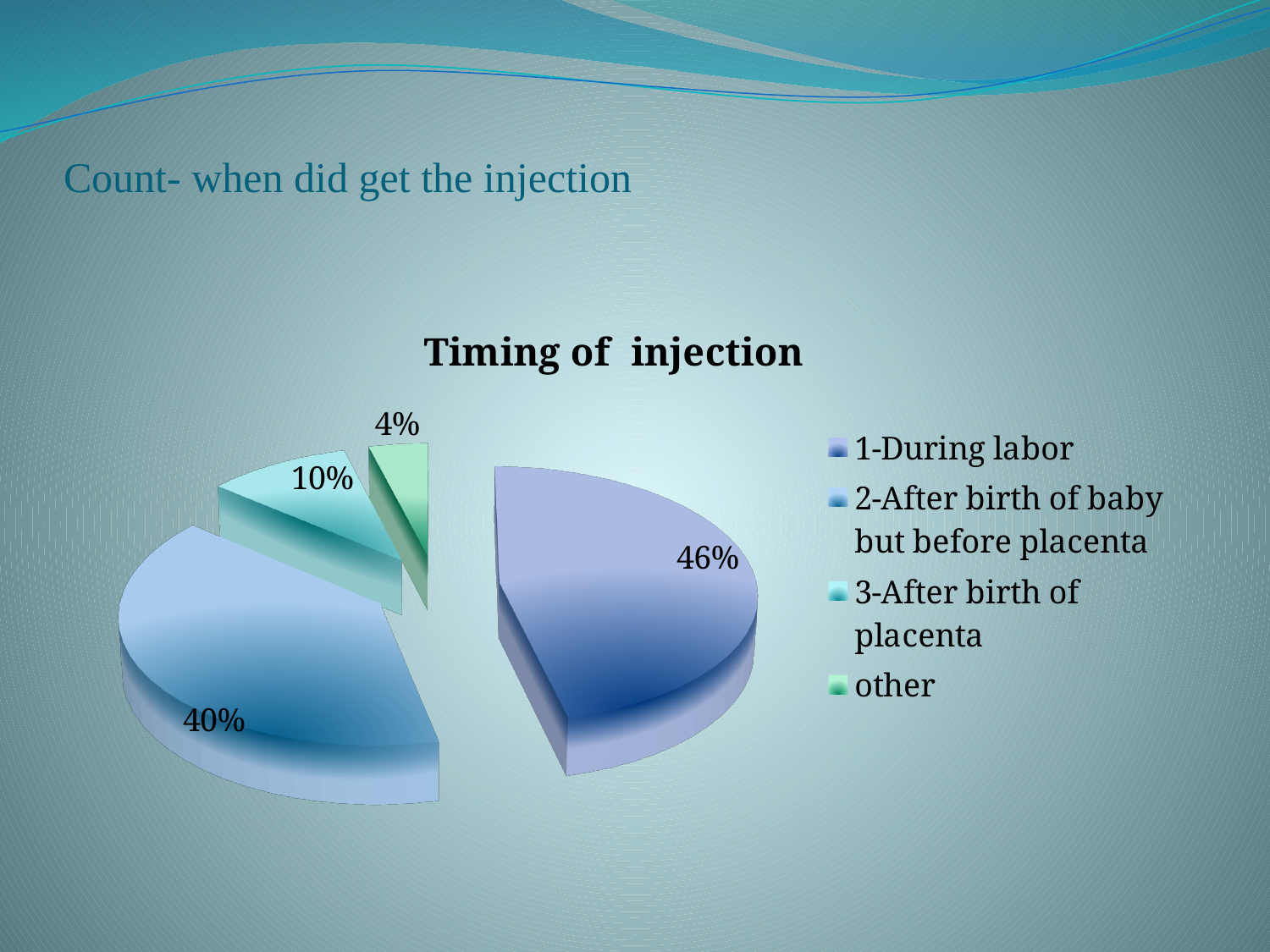
What share of the pie is labelled for '3-After birth of placenta'? 10% Which is larger: the slice for '3-After birth of placenta' or the slice for 'other'? 3-After birth of placenta What is the title of the chart? Timing of injection What share of the pie is labelled for 'other'? 4% Which category has the smallest slice of the pie? other What share of the pie is labelled for '2-After birth of baby but before placenta'? 40% What kind of chart is shown on the slide? pie chart What is the difference in percentage points between '3-After birth of placenta' and 'other'? 6% What is the difference in percentage points between '1-During labor' and '2-After birth of baby but before placenta'? 6% How many categories does the legend list? 4 Which category has the largest slice of the pie? 1-During labor